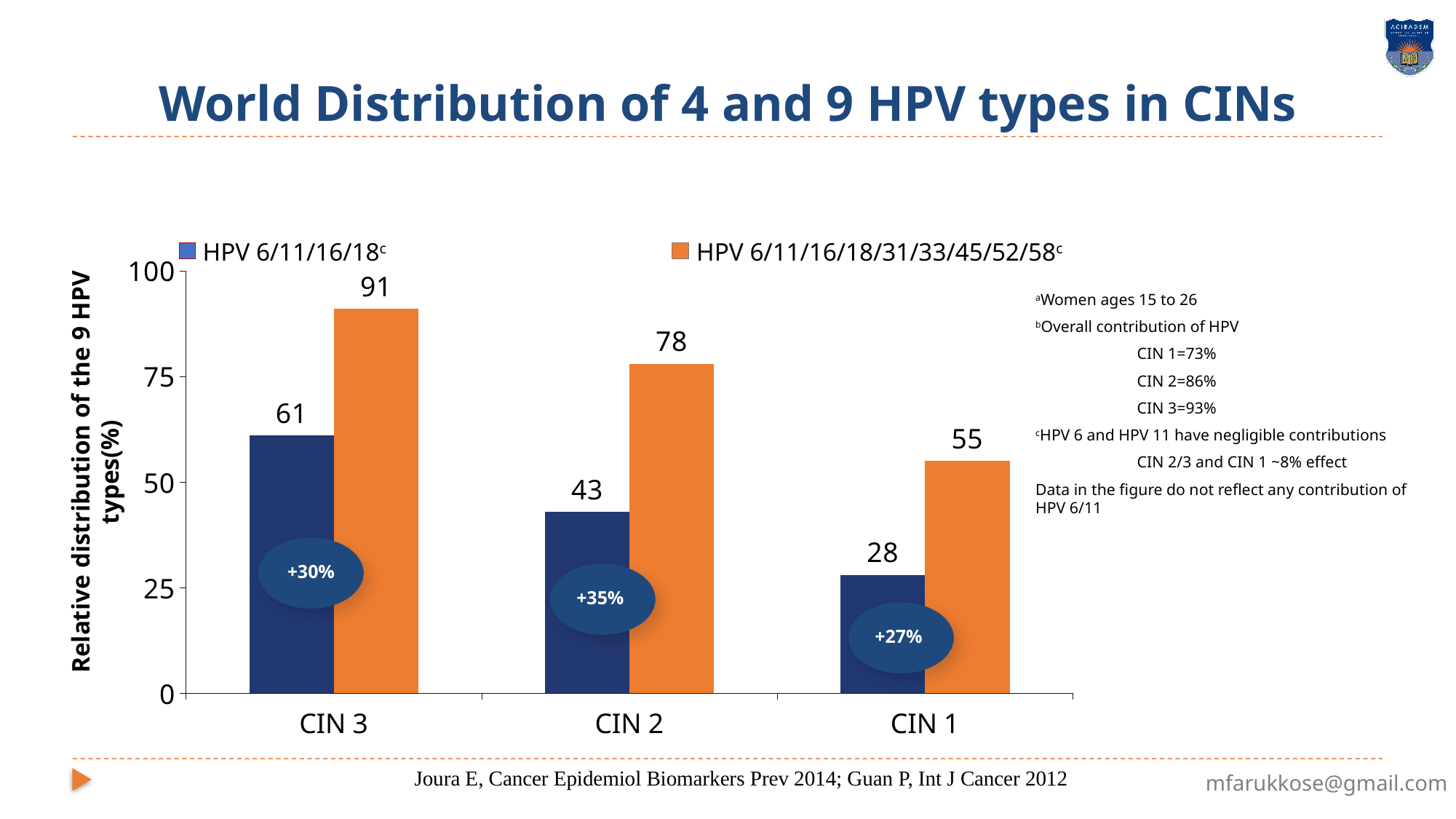
What is the difference between the HPV 6/11/16/18/31/33/45/52/58 value and the HPV 6/11/16/18 value in CIN 3? 30 What is the y-axis label of the chart? Relative distribution of the 9 HPV types(%) What is the value for HPV 6/11/16/18 in CIN 3? 61 Is the value for HPV 6/11/16/18/31/33/45/52/58 in CIN 1 greater or less than 50? greater What kind of chart is shown on the slide? bar chart Which category has the highest value for HPV 6/11/16/18/31/33/45/52/58? CIN 3 How many categories are shown on the x axis? 3 How many series does the legend list? 2 What is the value for HPV 6/11/16/18 in CIN 1? 28 What is the value for HPV 6/11/16/18/31/33/45/52/58 in CIN 2? 78 Which is larger in CIN 2: the HPV 6/11/16/18 value or the HPV 6/11/16/18/31/33/45/52/58 value? HPV 6/11/16/18/31/33/45/52/58 Which category has the lowest value for HPV 6/11/16/18? CIN 1